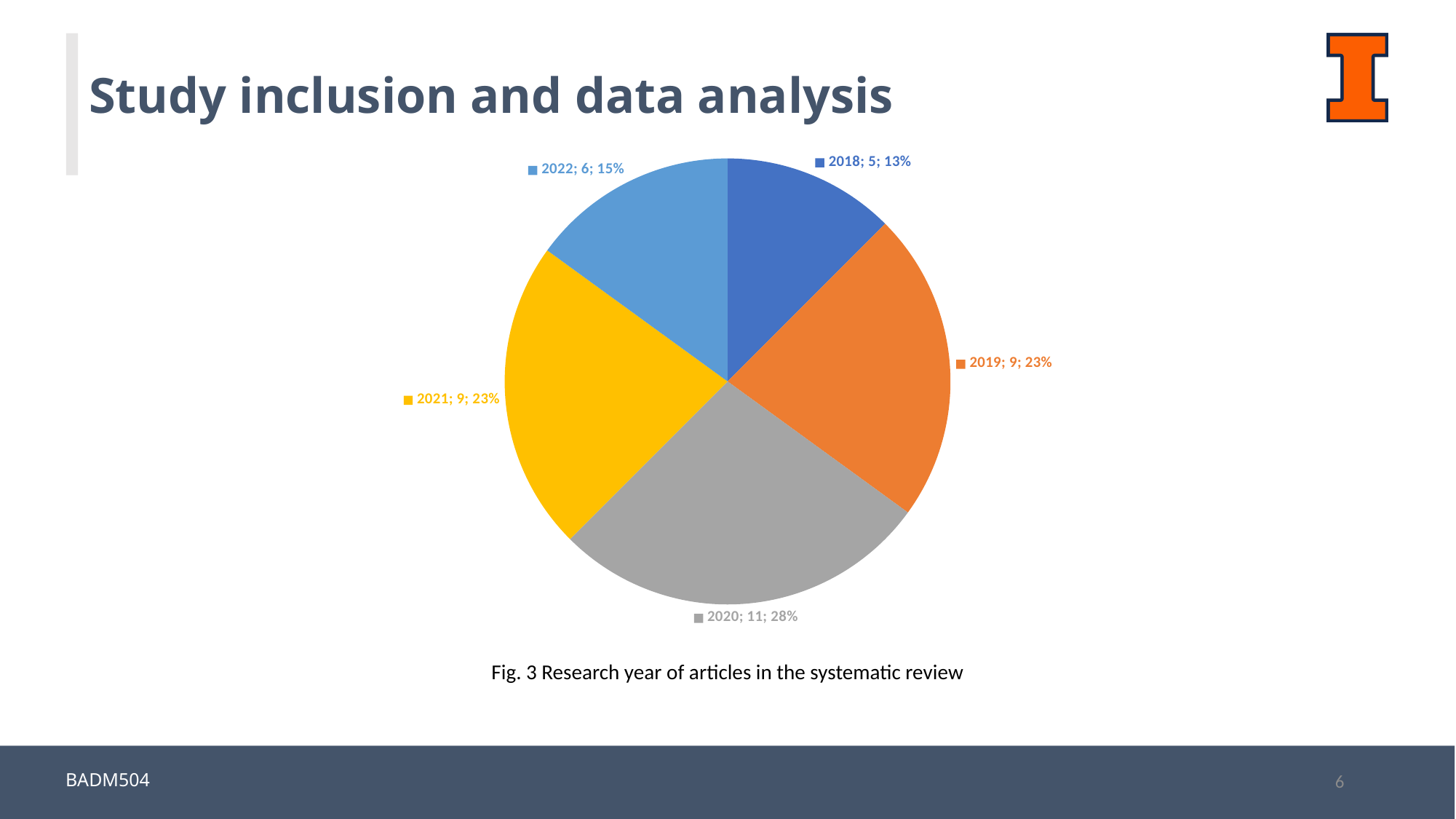
What is the difference in article count between 2020 and 2018? 6 How many slices does the pie chart have? 5 How many articles are from 2018? 5 Which year has the largest slice? 2020 What kind of chart is shown on the slide? pie chart What is the total number of articles across all years? 40 What is the figure caption below the chart? Fig. 3 Research year of articles in the systematic review What percentage share does 2021 have? 23% Which year has the smallest slice? 2018 Which has more articles, 2019 or 2022? 2019 What percentage share does 2022 have? 15% How many articles are from 2020? 11